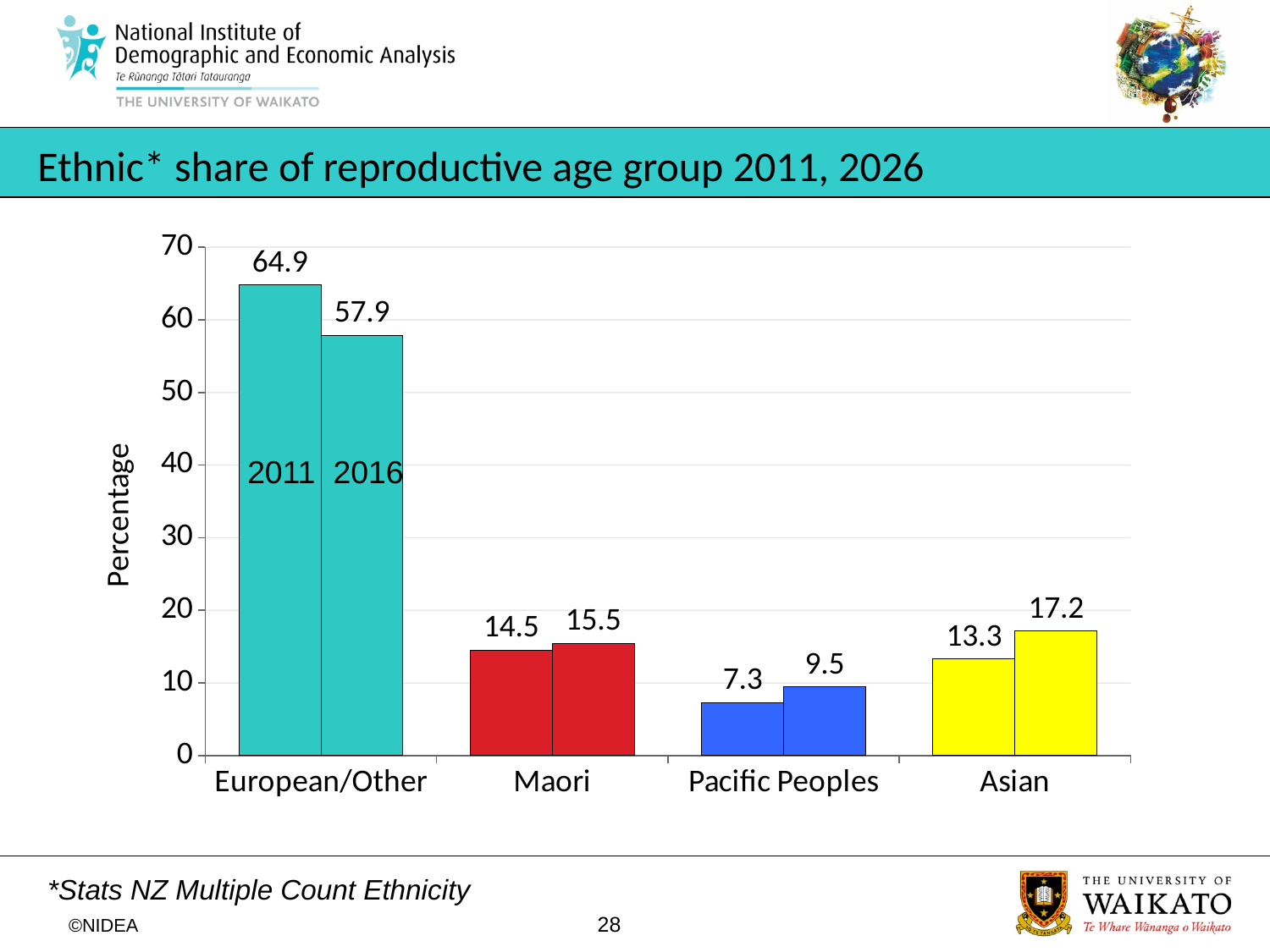
What is the 2011 value for Pacific Peoples? 7.3 Which category has the highest 2011 value? European/Other What is the difference between the 2011 and 2016 values for European/Other? 7.0 What is the 2011 value for European/Other? 64.9 Which is larger, the 2016 value for Maori or the 2016 value for Asian? Asian What is the difference between the 2016 and 2011 values for Asian? 3.9 What is the 2016 value for Maori? 15.5 How many ethnic categories are shown on the x axis? 4 What is the label on the y axis of the chart? Percentage What is the 2016 value for Asian? 17.2 Which category has the lowest 2016 value? Pacific Peoples What kind of chart is shown on the slide? Bar chart